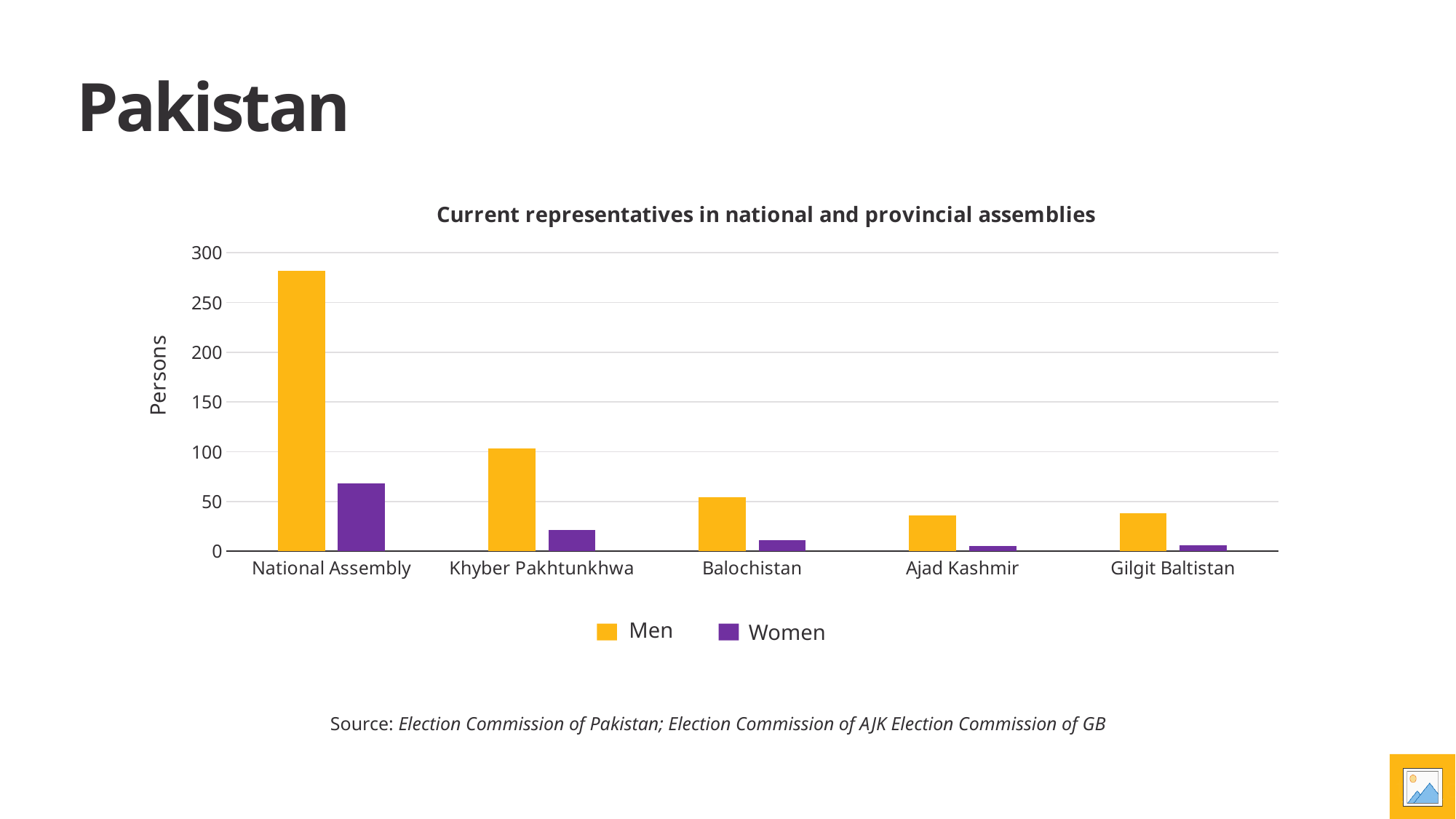
Is the value for Men in the National Assembly greater or less than 250? greater Which is larger: the number of men in Khyber Pakhtunkhwa or the number of men in Balochistan? Khyber Pakhtunkhwa What is the label of the y axis? Persons Is the value for Women in the National Assembly greater or less than 50? greater What kind of chart is shown on the slide? bar chart Which assembly has the highest number of women? National Assembly Is the value for Men in Khyber Pakhtunkhwa greater or less than 150? less How many series does the legend list? 2 Which assembly has the highest number of men? National Assembly What is the title of the chart? Current representatives in national and provincial assemblies How many assemblies (categories) are shown on the x axis? 5